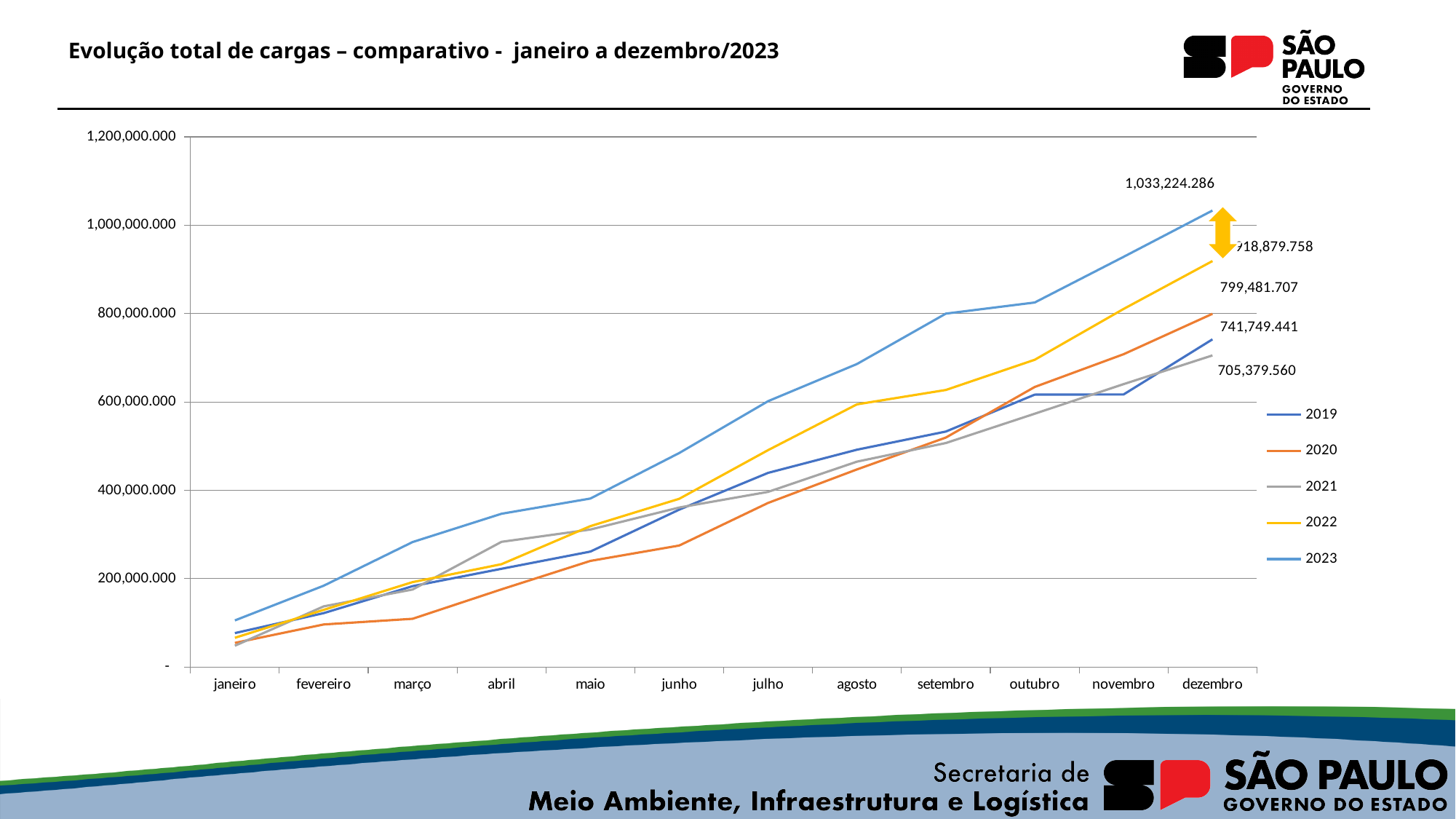
What is the difference between the dezembro values for 2023 and 2022? 114,344.528 Do the values for 2023 rise or fall from janeiro to dezembro? rise What is the value for 2022 in dezembro? 918,879.758 What type of chart is shown on the slide? line chart What is the value for 2023 in dezembro? 1,033,224.286 In dezembro, which is larger: the value for 2019 or the value for 2021? 2019 What is the value for 2020 in dezembro? 799,481.707 Which year has the highest value in dezembro? 2023 Which year has the lowest value in dezembro? 2021 How many months are shown along the x axis? 12 Is the value for 2023 in junho greater or less than 600,000.000? less How many series does the legend list? 5